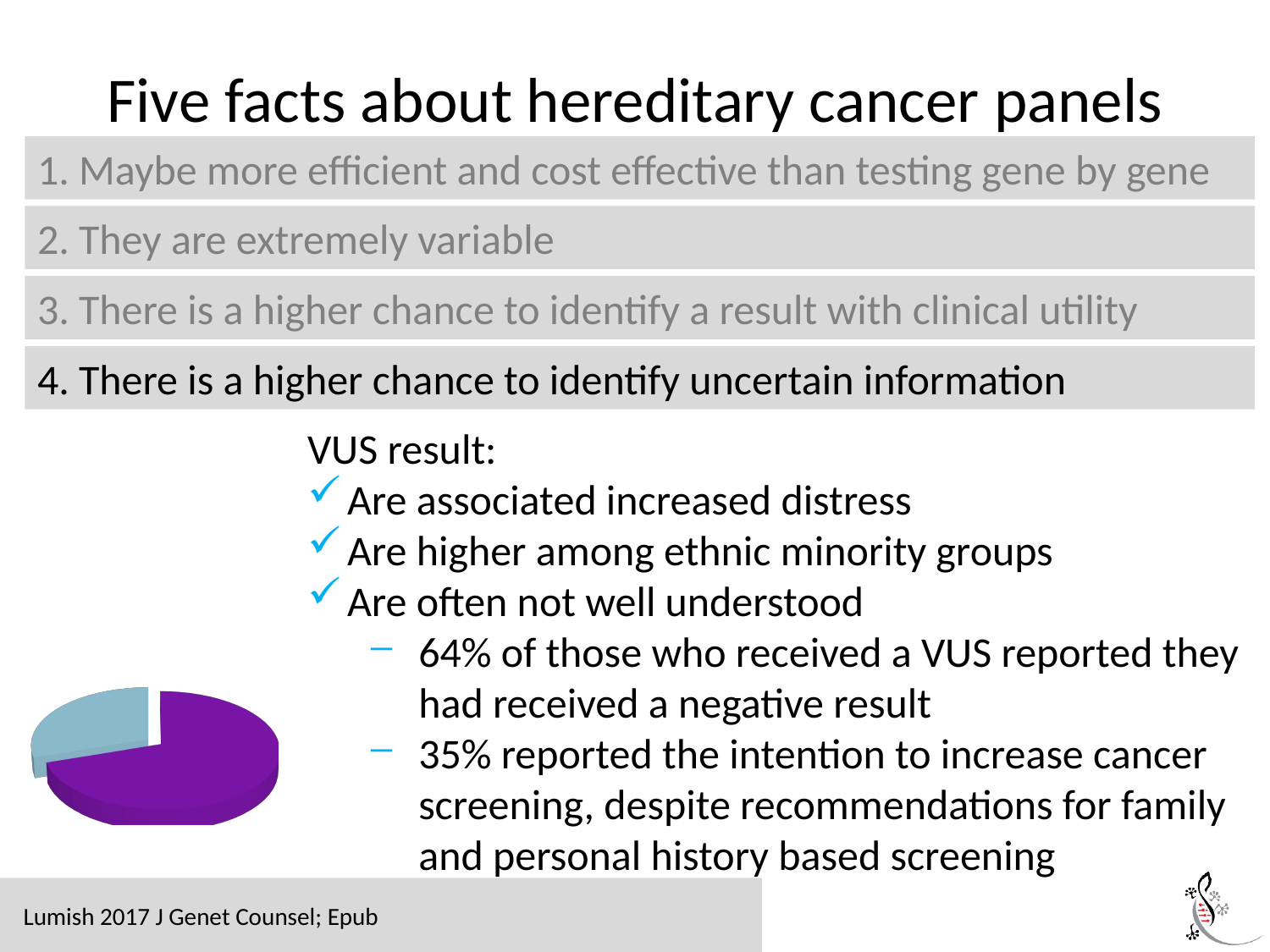
What kind of chart is shown on the slide? pie chart What two colours are used for the slices of the pie chart? purple and light blue Does the purple slice cover more or less than half of the pie chart? more How many slices does the pie chart have? 2 Which slice is larger in the pie chart, the purple one or the light blue one? purple Does the pie chart display a legend? No Which colour slice is the largest in the pie chart? purple Which colour slice is the smallest in the pie chart? light blue